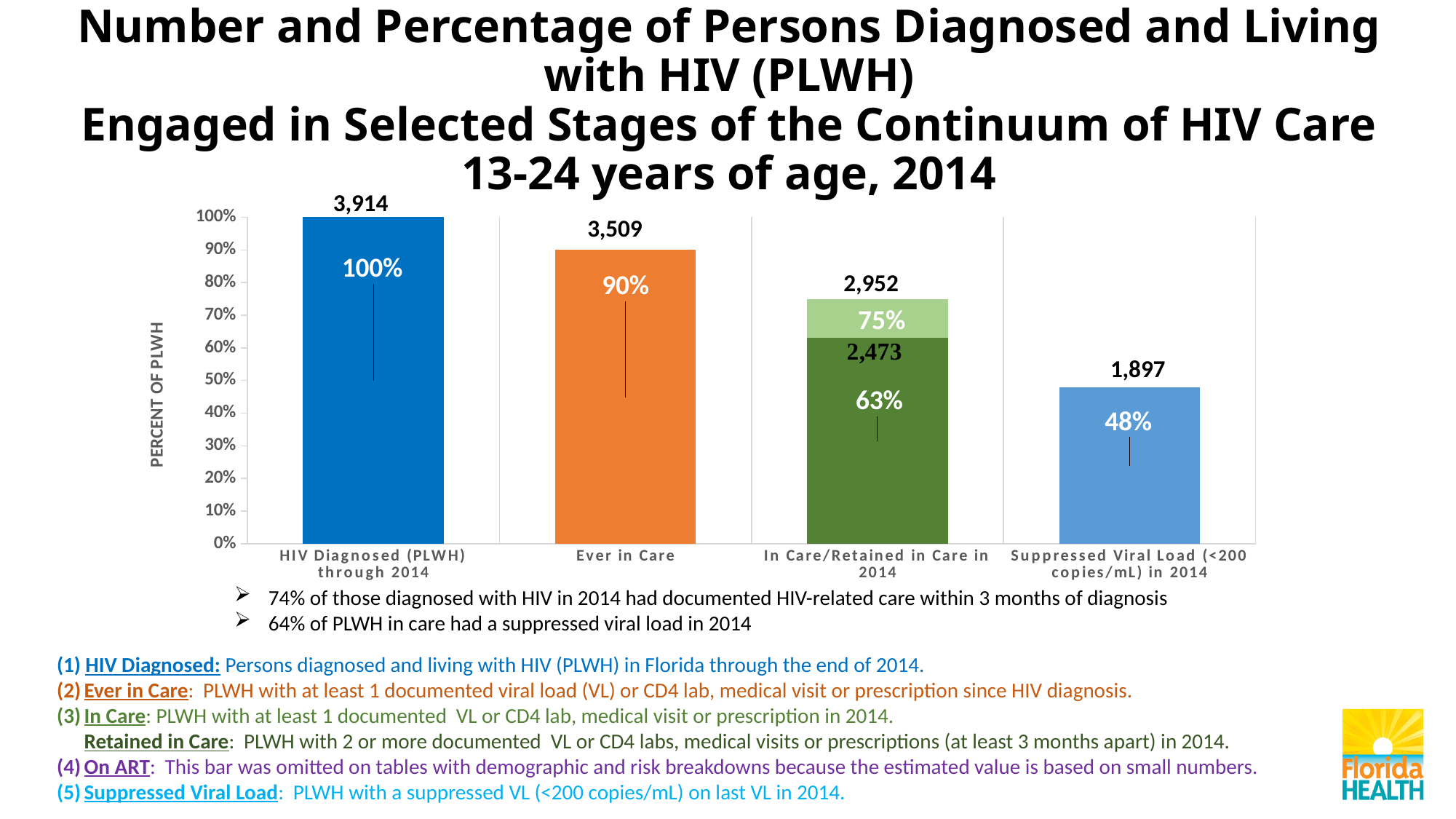
What number of persons is shown for 'Retained in Care' (the darker green portion of the 'In Care/Retained in Care in 2014' bar)? 2,473 What is the label of the y axis of the chart? PERCENT OF PLWH What is the difference in number of persons between 'Ever in Care' and 'Suppressed Viral Load (<200 copies/mL) in 2014'? 1,612 What percentage is shown for 'Suppressed Viral Load (<200 copies/mL) in 2014'? 48% What percentage is shown for 'In Care' (the top of the 'In Care/Retained in Care in 2014' bar)? 75% What is the number of persons shown for 'Ever in Care'? 3,509 What percentage is shown for the 'Ever in Care' bar? 90% Which category has the highest number of persons? HIV Diagnosed (PLWH) through 2014 What is the number of persons shown for the 'HIV Diagnosed (PLWH) through 2014' bar? 3,914 Which category has the lowest percentage of PLWH? Suppressed Viral Load (<200 copies/mL) in 2014 What kind of chart is shown on the slide? Bar chart How many categories are shown on the x axis of the chart? 4